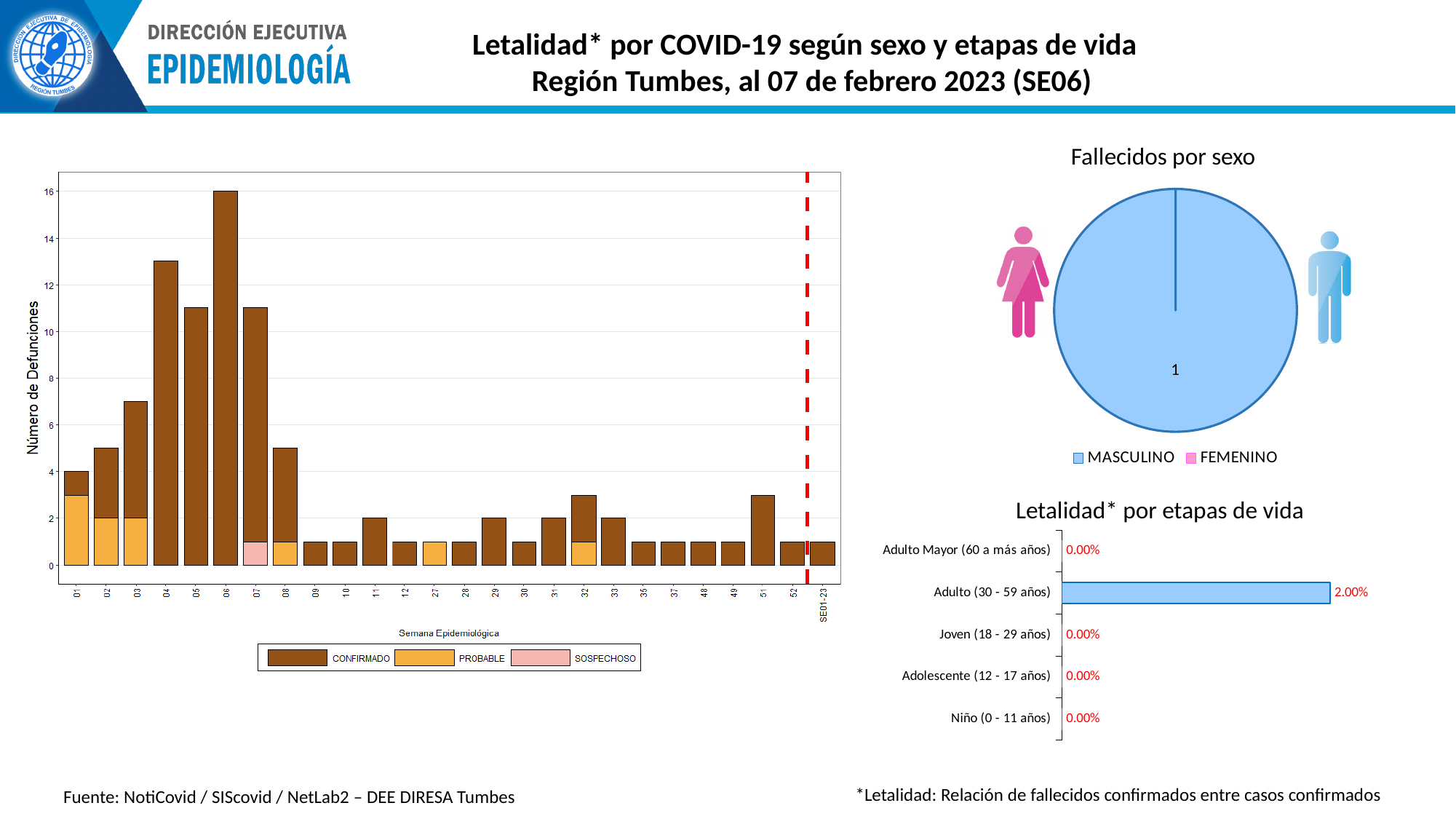
What kind of chart is the chart on the left showing Número de Defunciones by Semana Epidemiológica? bar chart In the left chart of Número de Defunciones by Semana Epidemiológica, which week has the highest bar? 06 How many entries does the legend of the pie chart 'Fallecidos por sexo' list? 2 In the chart 'Letalidad* por etapas de vida', which age group has the highest value? Adulto (30 - 59 años) In the chart 'Letalidad* por etapas de vida', what is the value for Niño (0 - 11 años)? 0.00% In the left chart of Número de Defunciones by Semana Epidemiológica, is the value for week 04 greater or less than 12? greater In the chart 'Letalidad* por etapas de vida', what is the value for Adulto (30 - 59 años)? 2.00% How many age groups are shown in the chart 'Letalidad* por etapas de vida'? 5 In the left chart of Número de Defunciones by Semana Epidemiológica, what is the total height of the bar for week 06? 16 In the pie chart 'Fallecidos por sexo', what value is printed on the slice? 1 In the left chart of Número de Defunciones by Semana Epidemiológica, is the value for week 09 greater or less than 2? less How many series does the legend of the left chart of Número de Defunciones list? 3